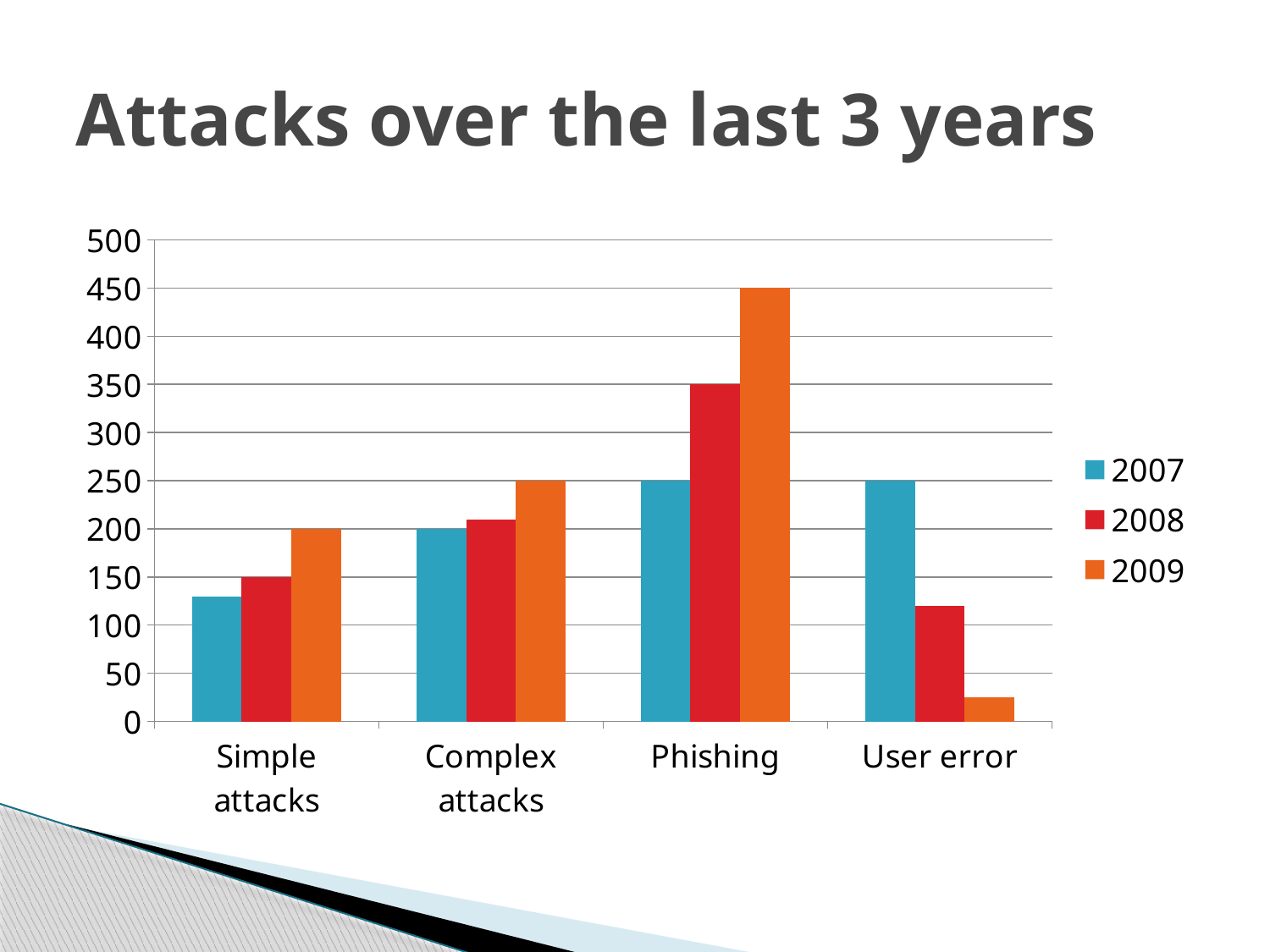
Which category has the lowest value in 2009? User error What type of chart is shown on the slide? bar chart What is the value for Phishing in 2008? 350 What is the title of the chart? Attacks over the last 3 years What is the value for Phishing in 2009? 450 What is the difference between the 2009 and 2007 values for Phishing? 200 How many series does the legend list? 3 What is the value for Simple attacks in 2009? 200 How many categories are shown on the x axis? 4 Is the value for User error in 2008 greater or less than 150? less Which category has the highest value in 2009? Phishing Which is larger for User error: the 2007 value or the 2009 value? 2007